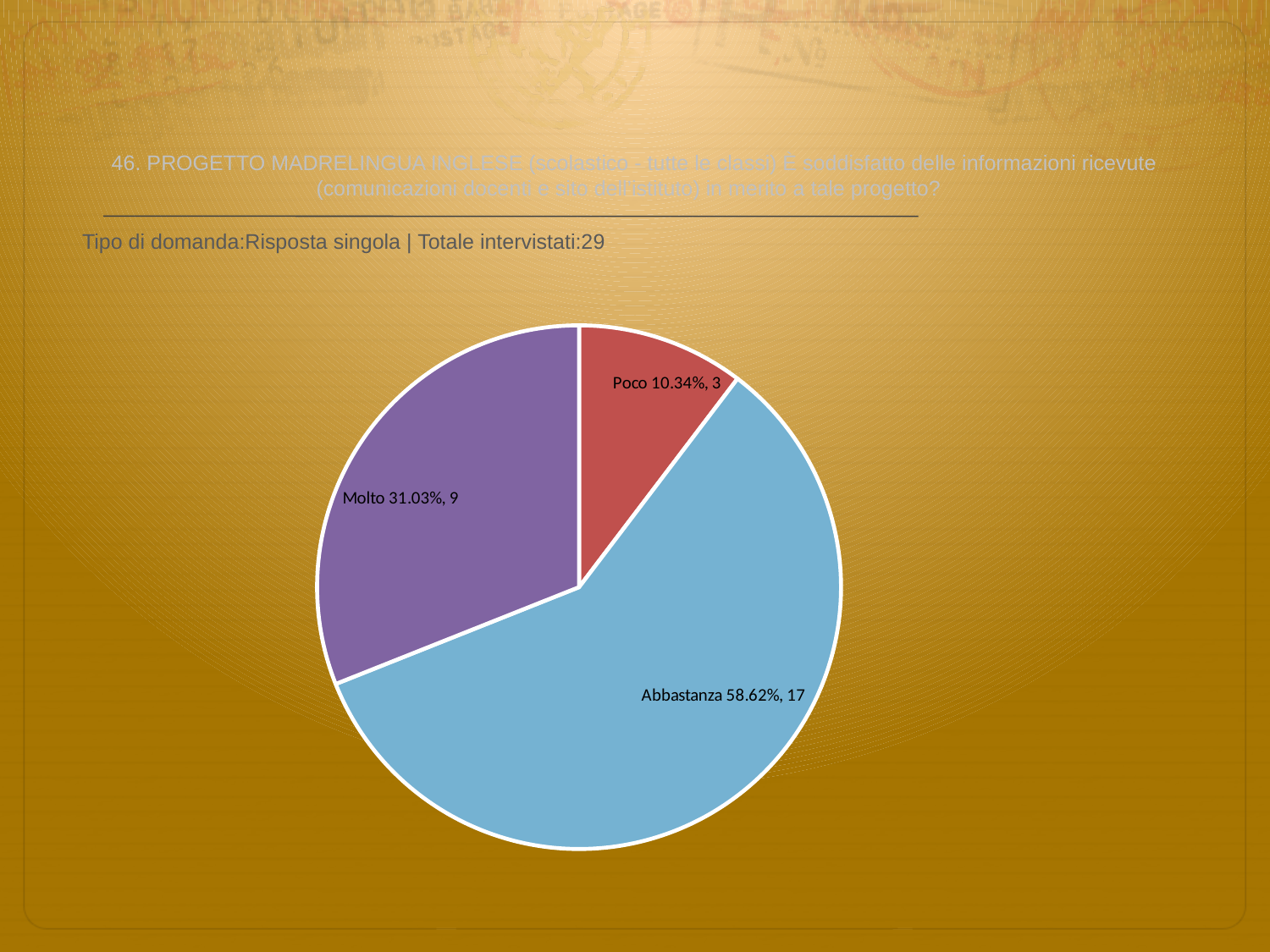
What is the difference in respondent count between Abbastanza and Molto? 8 How many slices does the pie chart have? 3 What percentage share does the Poco slice have? 10.34% What percentage share does the Abbastanza slice have? 58.62% Which response category has the smallest slice? Poco Which slice is larger, Molto or Poco? Molto How many respondents answered Abbastanza? 17 How many respondents answered Molto? 9 How many respondents answered Poco? 3 What percentage share does the Molto slice have? 31.03% Which response category has the largest slice? Abbastanza What kind of chart is shown on the slide? pie chart